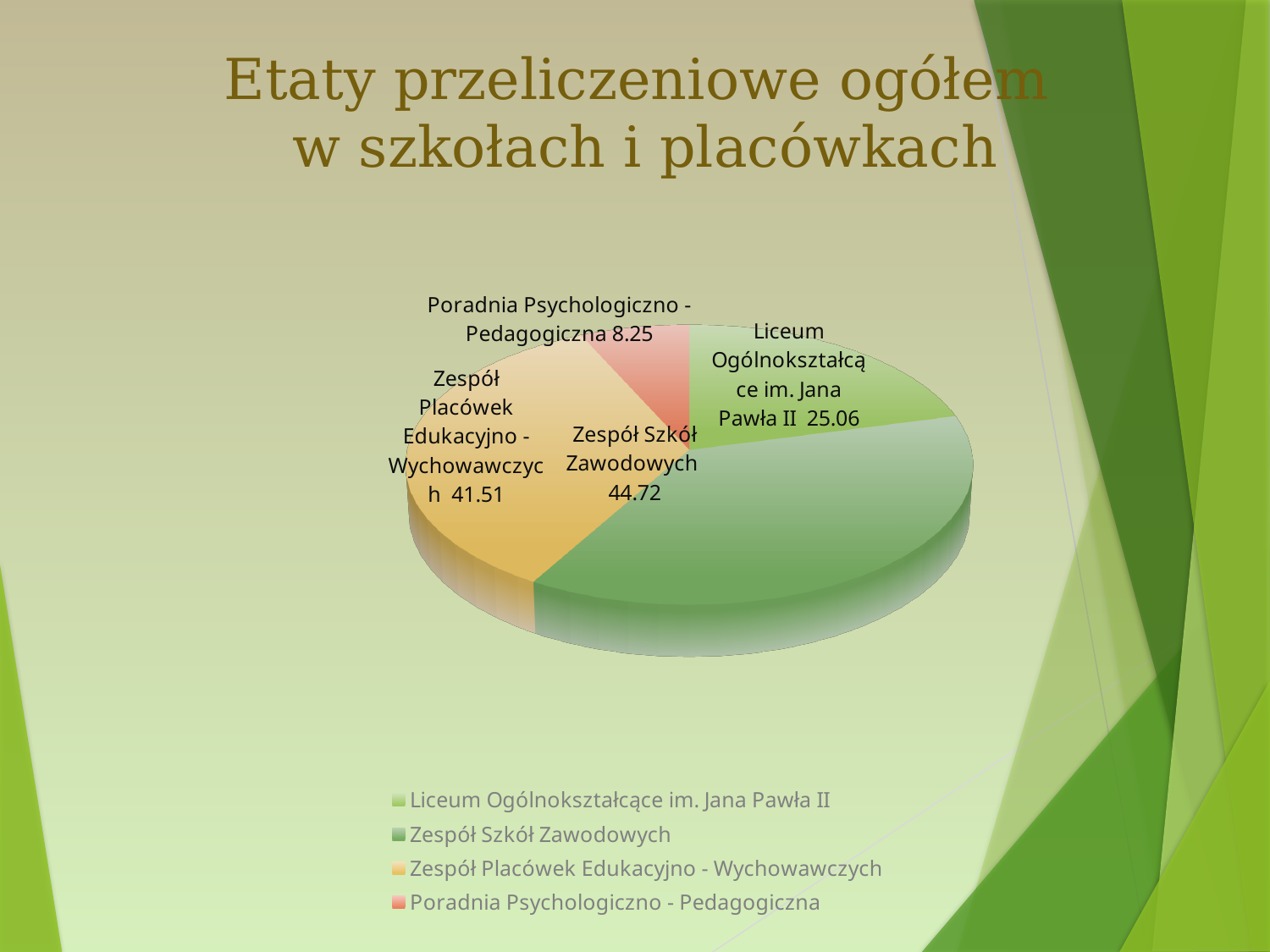
What is the value for Poradnia Psychologiczno - Pedagogiczna? 8.25 What is the difference between the values for Zespół Placówek Edukacyjno - Wychowawczych and Poradnia Psychologiczno - Pedagogiczna? 33.26 What is the value for Zespół Szkół Zawodowych? 44.72 What kind of chart is shown on the slide? pie chart How many slices does the pie chart have? 4 Which category has the largest value? Zespół Szkół Zawodowych What is the title of the slide containing the chart? Etaty przeliczeniowe ogółem w szkołach i placówkach Which category has the smallest value? Poradnia Psychologiczno - Pedagogiczna What is the value for Zespół Placówek Edukacyjno - Wychowawczych? 41.51 What is the difference between the values for Zespół Szkół Zawodowych and Liceum Ogólnokształcące im. Jana Pawła II? 19.66 Which is larger, the value for Liceum Ogólnokształcące im. Jana Pawła II or the value for Poradnia Psychologiczno - Pedagogiczna? Liceum Ogólnokształcące im. Jana Pawła II What is the value for Liceum Ogólnokształcące im. Jana Pawła II? 25.06